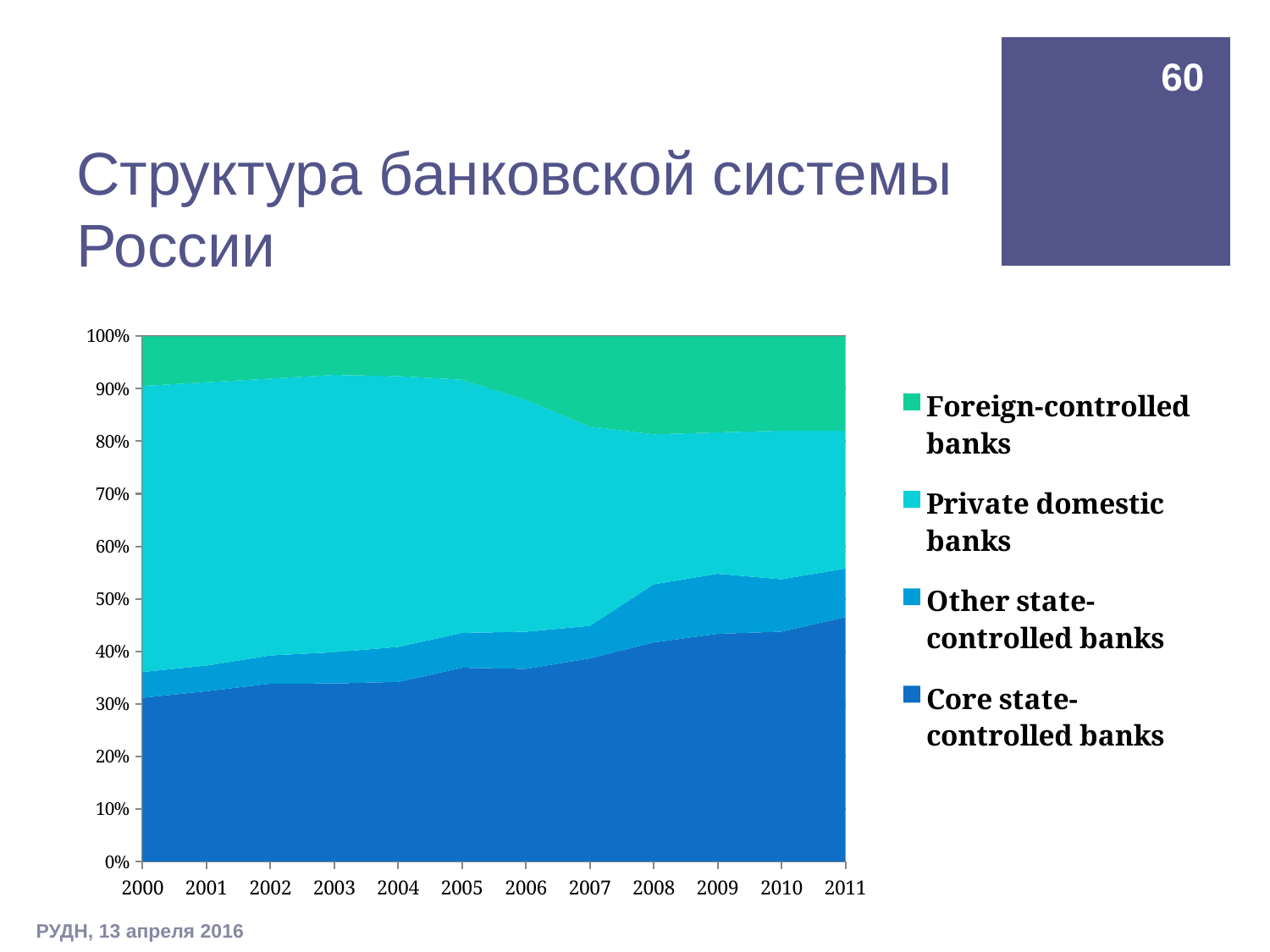
What kind of chart is shown on the slide? Stacked area chart Is the share of Private domestic banks in 2000 greater or less than 50%? greater How many series does the chart legend list? 4 In 2011, which has the larger share: Core state-controlled banks or Private domestic banks? Core state-controlled banks How many years are shown along the x axis of the chart? 12 Does the share of Private domestic banks rise or fall from 2000 to 2011? Fall Is the share of Core state-controlled banks in 2011 greater or less than 40%? greater Does the share of Core state-controlled banks rise or fall from 2000 to 2011? Rise Which series is shown at the top of the stacked area chart? Foreign-controlled banks Which series is shown at the bottom of the stacked area chart? Core state-controlled banks Which series has the largest share in 2000? Private domestic banks Is the share of Core state-controlled banks in 2000 greater or less than 40%? less